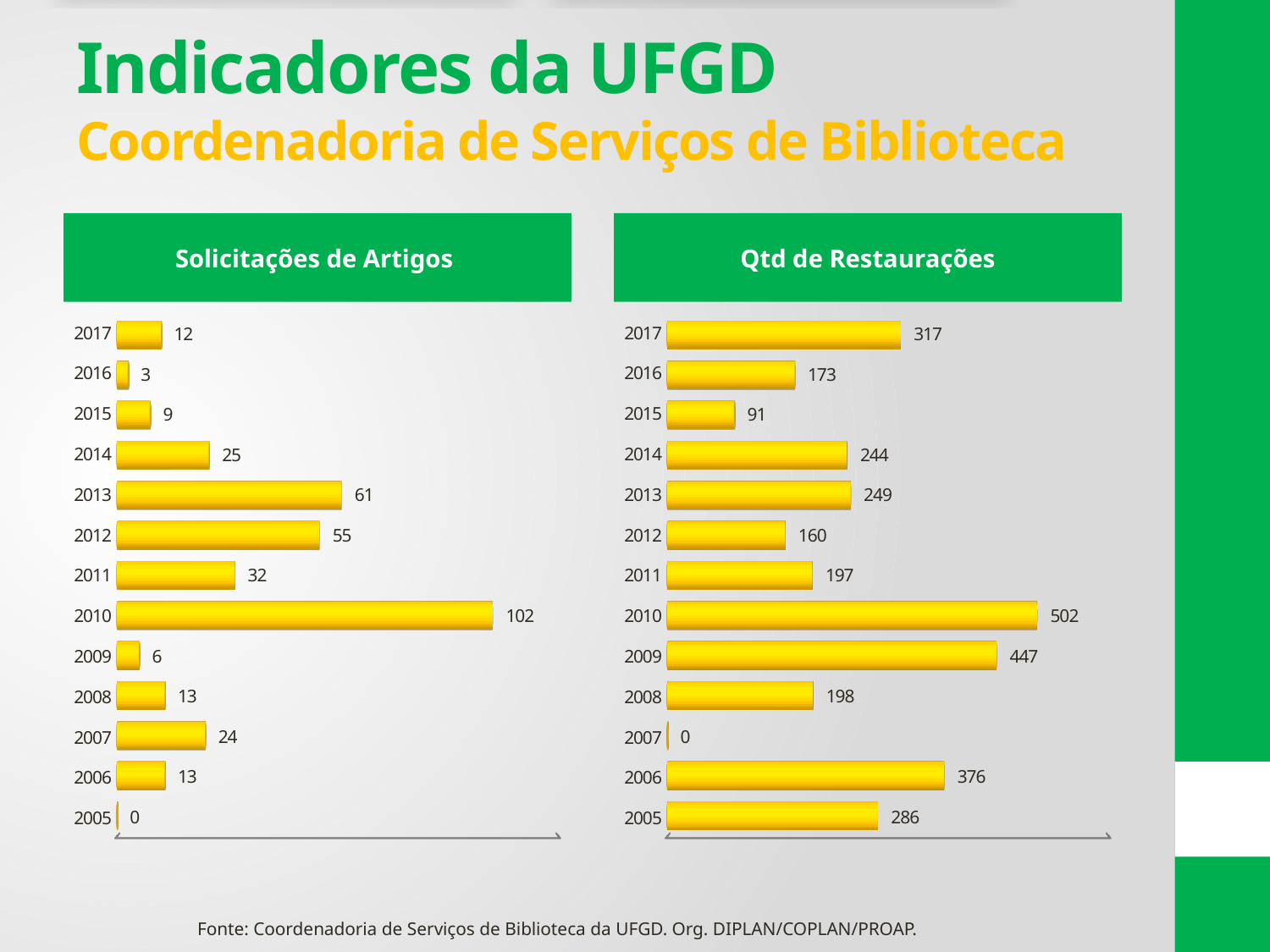
In the 'Qtd de Restaurações' chart, what is the difference between the values for 2010 and 2009? 55 In the 'Qtd de Restaurações' chart, which year has the lowest value? 2007 What is the title of the chart on the left side of the slide? Solicitações de Artigos In the 'Qtd de Restaurações' chart, which is larger, the value for 2006 or the value for 2017? 2006 In the 'Solicitações de Artigos' chart, what is the value for 2010? 102 In the 'Solicitações de Artigos' chart, which year has the lowest value? 2005 In the 'Qtd de Restaurações' chart, what is the value for 2016? 173 In the 'Solicitações de Artigos' chart, which is larger, the value for 2014 or the value for 2007? 2014 In the 'Solicitações de Artigos' chart, what is the difference between the values for 2013 and 2012? 6 What kind of chart is the 'Qtd de Restaurações' chart? Bar chart In the 'Qtd de Restaurações' chart, which year has the highest value? 2010 How many years are shown in the 'Solicitações de Artigos' chart? 13